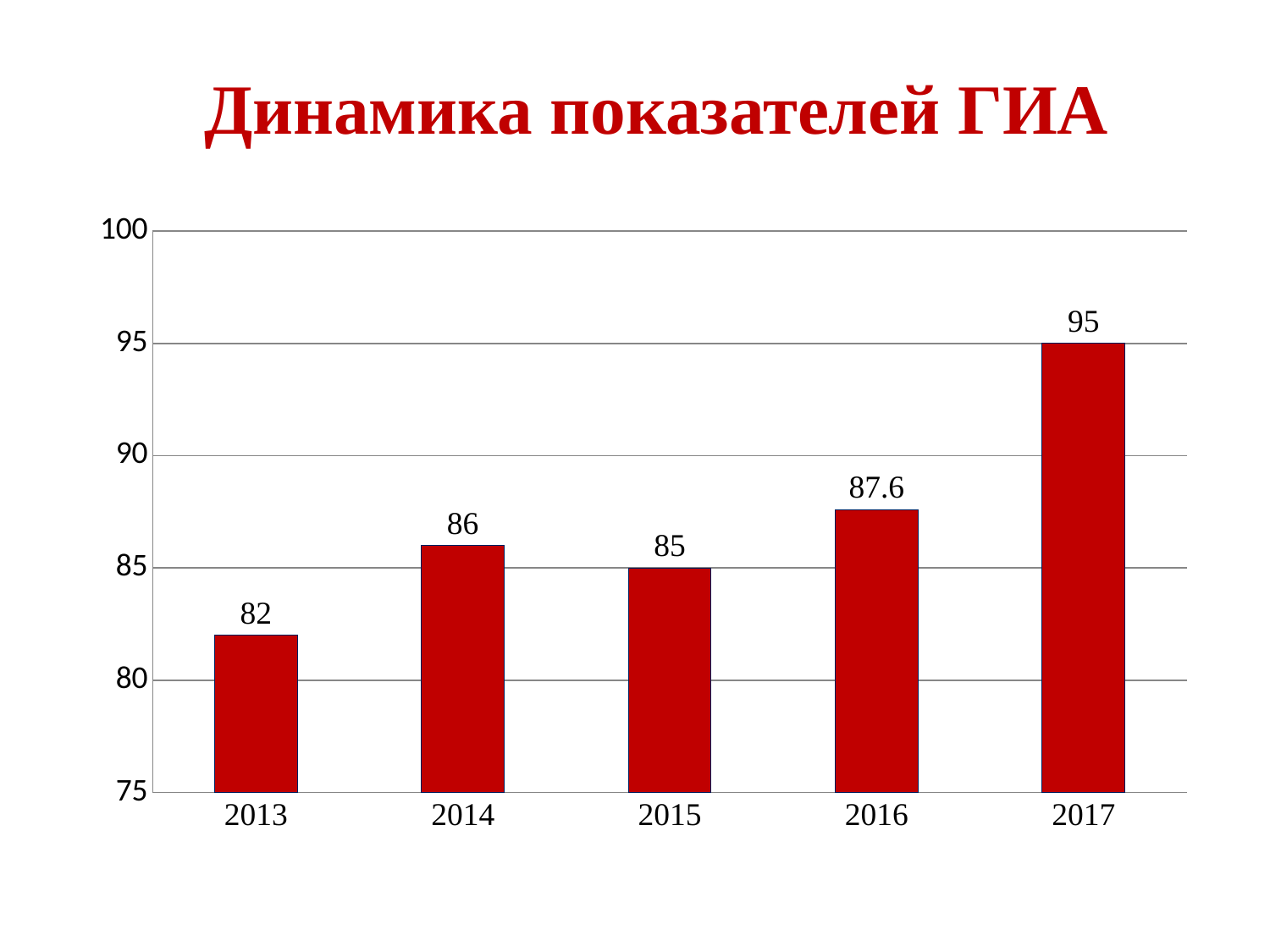
What kind of chart is shown on the slide? bar chart Is the value for 2016 greater or less than 85? greater Which year has the lowest value? 2013 What is the difference between the values for 2017 and 2013? 13 What is the difference between the values for 2014 and 2015? 1 What is the value for 2013? 82 How many years are shown on the x axis? 5 What is the title of the chart? Динамика показателей ГИА Which is larger, the value for 2014 or the value for 2015? 2014 Which year has the highest value? 2017 What is the value for 2016? 87.6 What is the value for 2017? 95